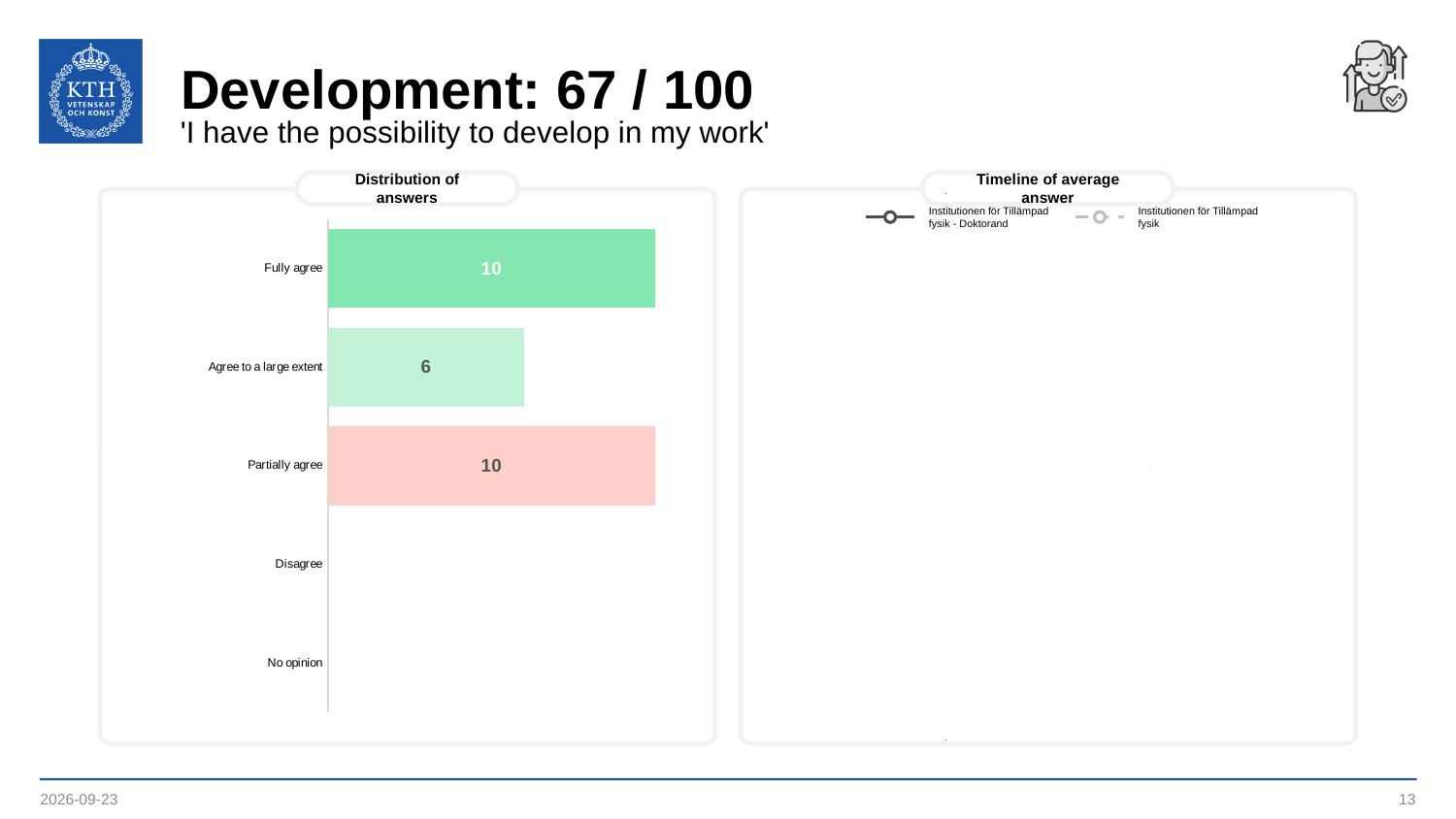
How many series does the legend of the 'Timeline of average answer' chart list? 2 What are the two legend entries of the 'Timeline of average answer' chart? Institutionen för Tillämpad fysik - Doktorand; Institutionen för Tillämpad fysik In the 'Distribution of answers' chart, what is the difference between the values for 'Fully agree' and 'Agree to a large extent'? 4 In the 'Distribution of answers' chart, what is the value for 'Partially agree'? 10 In the 'Distribution of answers' chart, how many categories have a visible bar? 3 How many categories are listed on the axis of the 'Distribution of answers' chart? 5 In the 'Distribution of answers' chart, what is the value for 'Agree to a large extent'? 6 In the 'Distribution of answers' chart, which is larger: the value for 'Partially agree' or the value for 'Agree to a large extent'? Partially agree In the 'Distribution of answers' chart, what is the value for 'Fully agree'? 10 In the 'Distribution of answers' chart, which is larger: the value for 'Fully agree' or the value for 'Agree to a large extent'? Fully agree What is the title of the chart on the left side of the slide? Distribution of answers What kind of chart is the 'Distribution of answers' chart? Bar chart